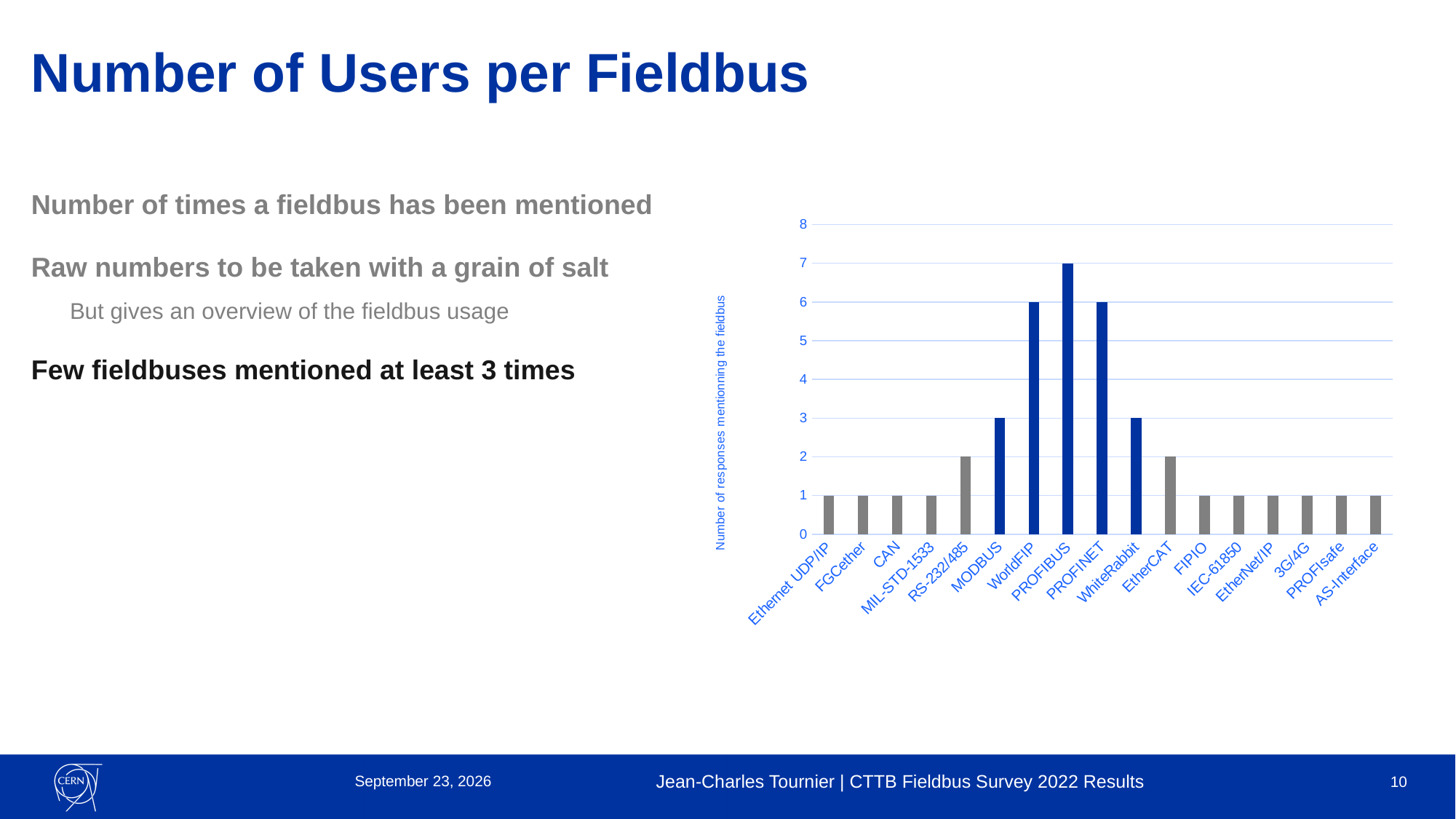
What type of chart is shown on the slide? bar chart What is the value for MODBUS in the chart? 3 Is the value for PROFINET greater or less than 4? greater What is the value for WorldFIP in the chart? 6 What is the value for EtherCAT in the chart? 2 Which is larger, the value for WhiteRabbit or the value for RS-232/485? WhiteRabbit Which fieldbus has the highest number of responses in the chart? PROFIBUS What is the label of the vertical axis of the chart? Number of responses mentionning the fieldbus What is the value for PROFIBUS in the chart? 7 What colour are the bars for fieldbuses mentioned at least 3 times? blue How many fieldbuses are shown on the x axis of the chart? 17 What is the difference between the values for PROFIBUS and PROFINET? 1